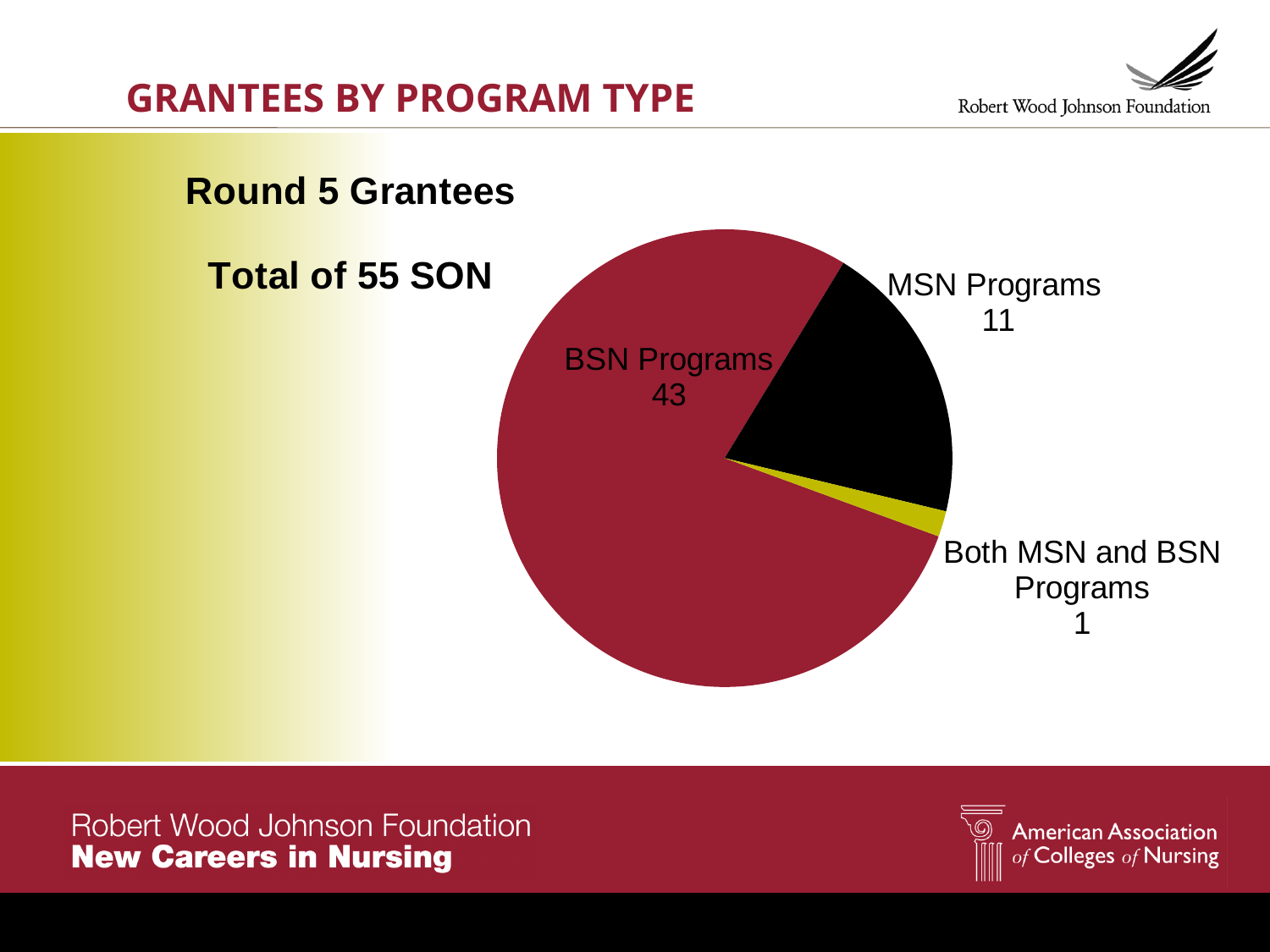
How many slices does the pie chart have? 3 How many BSN Programs grantees are shown in the pie chart? 43 Which program type has the smallest slice of the pie chart? Both MSN and BSN Programs How many MSN Programs grantees are shown in the pie chart? 11 How many grantees have Both MSN and BSN Programs according to the pie chart? 1 Which program type has the largest slice of the pie chart? BSN Programs Which is larger, the number of MSN Programs grantees or the number with Both MSN and BSN Programs? MSN Programs What is the difference between the number of BSN Programs and MSN Programs grantees? 32 What is the title of the slide containing the pie chart? GRANTEES BY PROGRAM TYPE What kind of chart is shown on the slide? pie chart What is the total number of grantees across all slices of the pie chart? 55 What share of the pie chart do MSN Programs represent? 20%